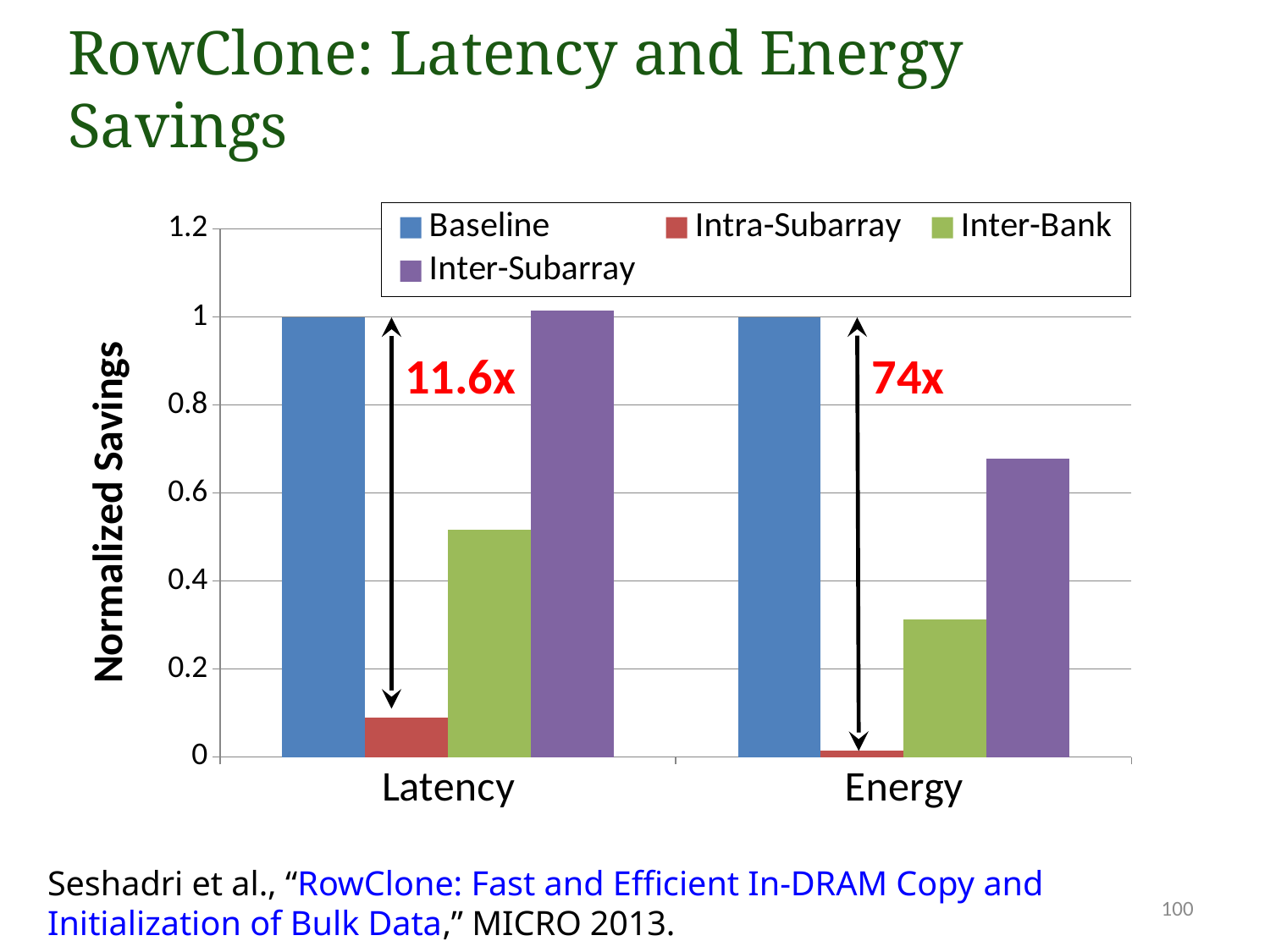
Is the Inter-Bank value for Energy greater or less than 0.4? less Is the Inter-Bank value for Latency greater or less than 0.4? greater Which is larger, the Inter-Bank value for Latency or the Inter-Bank value for Energy? Latency Which series has the highest value for Energy? Baseline Is the Inter-Subarray value for Energy greater or less than 0.6? greater Which series has the lowest value for Energy? Intra-Subarray What kind of chart is shown on the slide? bar chart What is the Baseline value for Latency? 1 What is the Baseline value for Energy? 1 How many categories are shown on the x axis? 2 How many series does the legend list? 4